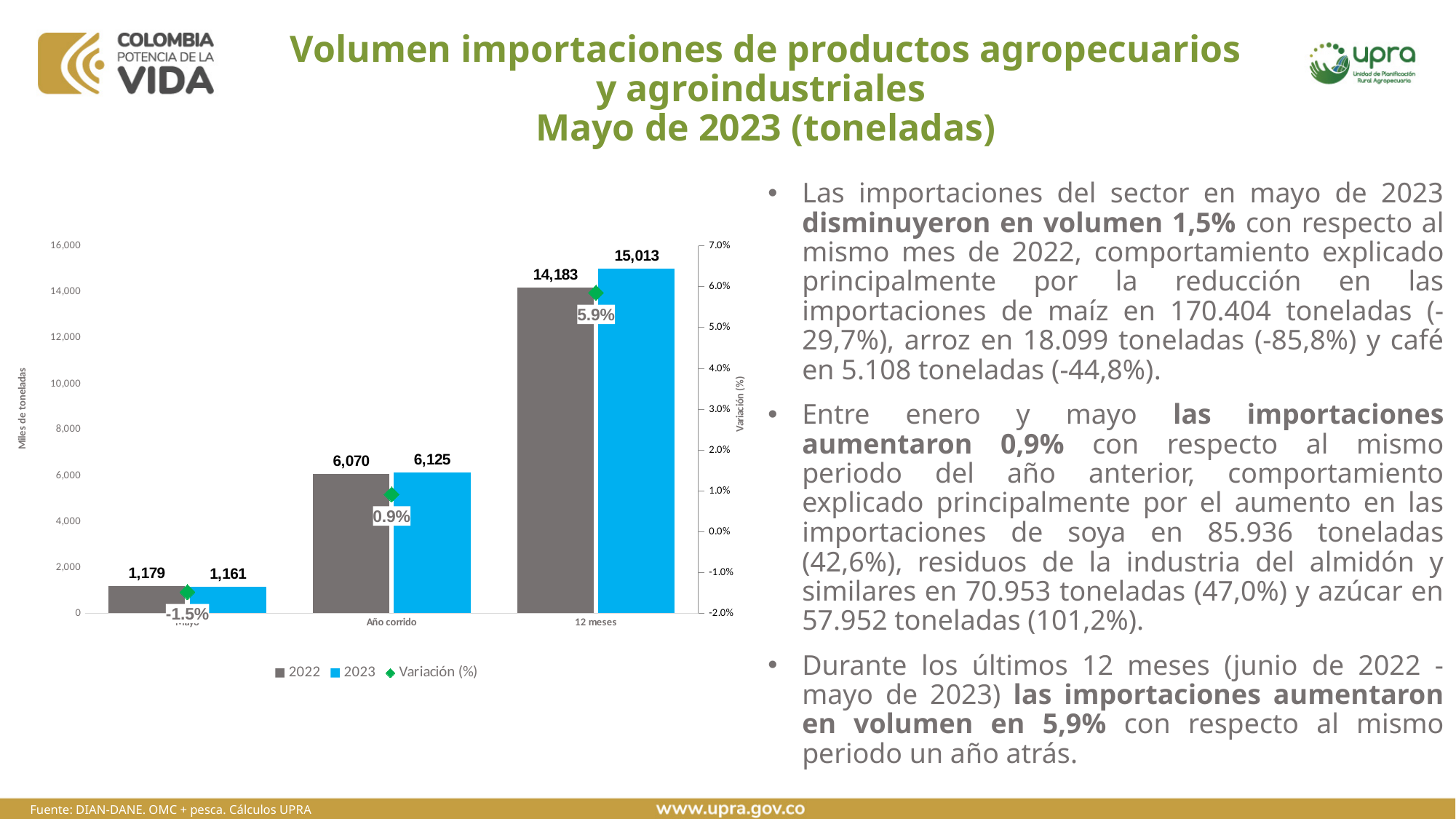
What kind of chart is this? Bar chart with a line/marker series What is the difference between the 2023 and 2022 values for 12 meses? 830 How many categories are shown on the x axis? 3 What is the 2022 value for Año corrido? 6,070 What is the 2023 value for 12 meses? 15,013 For Año corrido, which is larger, the 2022 value or the 2023 value? 2023 Which category has the highest 2023 value? 12 meses What is the Variación (%) value for Mayo? -1.5% Which category has the lowest 2022 value? Mayo What is the label of the left vertical axis? Miles de toneladas What is the Variación (%) value for 12 meses? 5.9% How many series does the legend list? 3